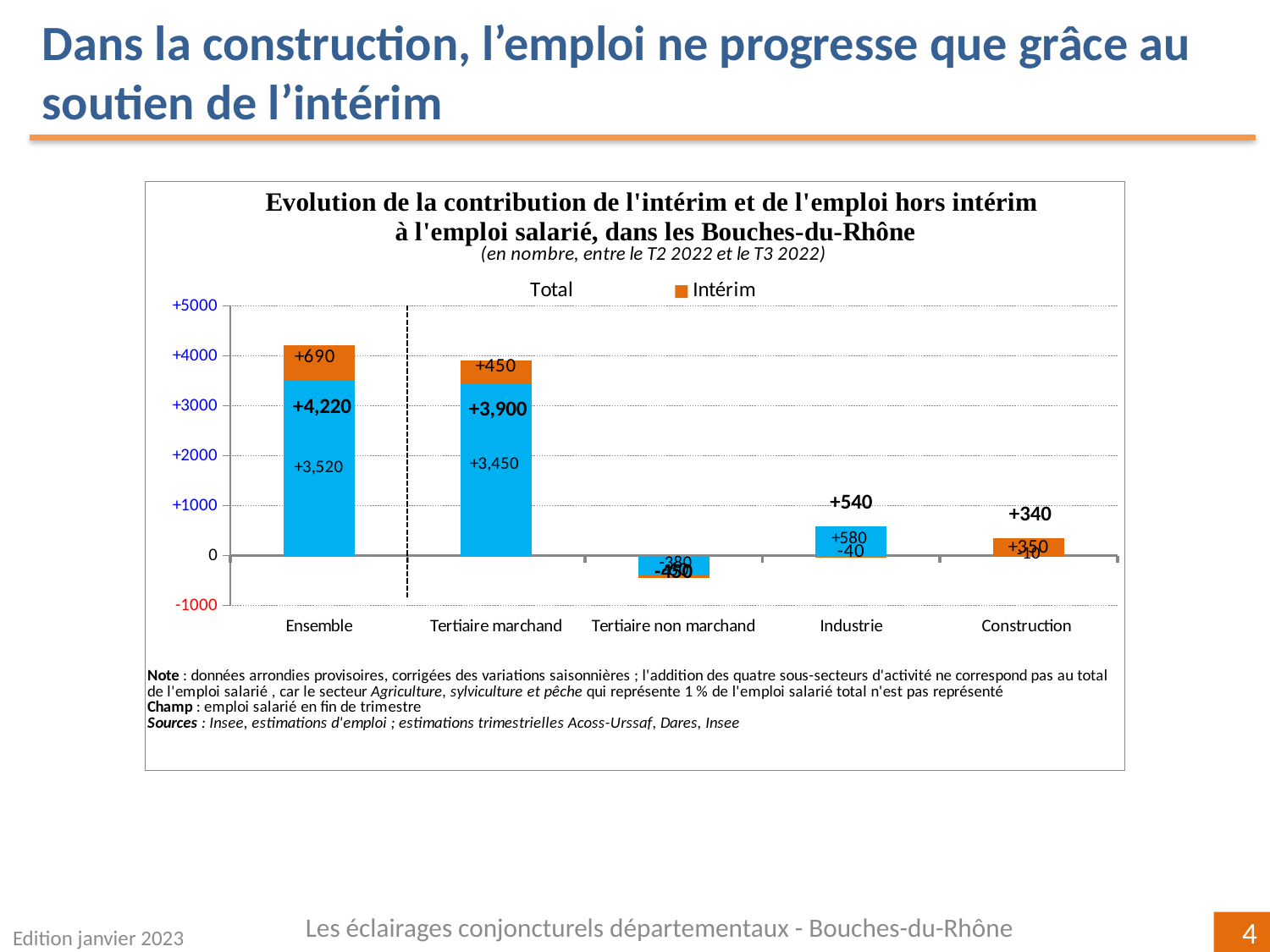
What is the total value shown for Ensemble? +4,220 What is the total value shown for Construction? +340 How many series does the chart legend list? 2 What is the Intérim value shown for Tertiaire marchand? +450 Which category has the lowest total value? Tertiaire non marchand What is the total value shown for Industrie? +540 Which category has the highest total value? Ensemble What is the Intérim value shown for Ensemble? +690 What is the difference between the total for Ensemble and the total for Tertiaire marchand? 320 What kind of chart is shown on the slide? bar chart Which has the larger total value, Industrie or Construction? Industrie How many sector categories are shown on the x axis of the chart? 5